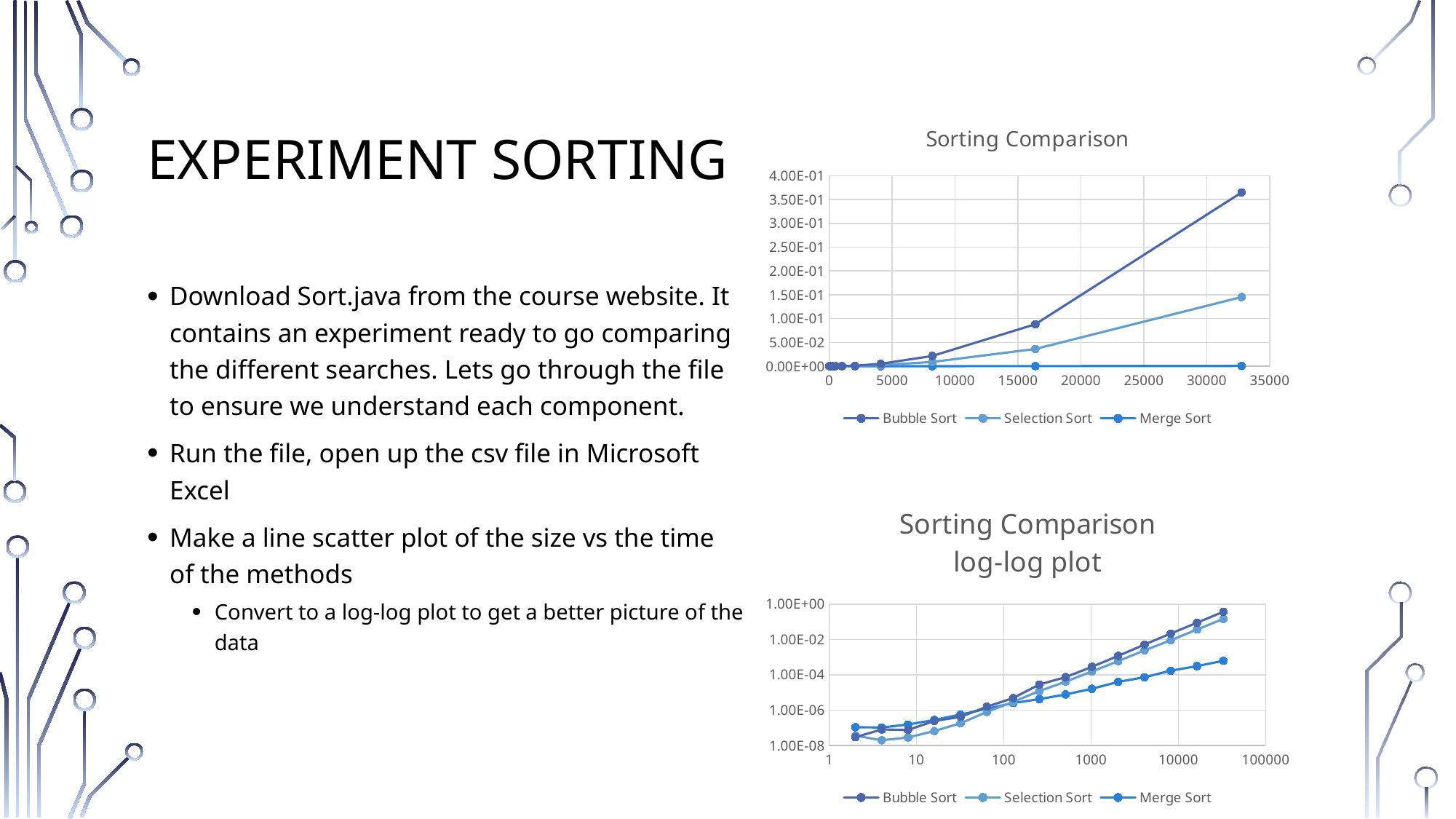
In the "Sorting Comparison" chart, which is larger at the largest input size: Bubble Sort or Selection Sort? Bubble Sort How many series does the legend of the "Sorting Comparison" chart list? 3 In the "Sorting Comparison log-log plot" chart, which series has the lowest value at the largest input size? Merge Sort In the "Sorting Comparison" chart, is the Bubble Sort value at the largest input size greater or less than 3.00E-01? greater What kind of chart is the top chart titled "Sorting Comparison"? line chart In the "Sorting Comparison" chart, does the Bubble Sort series rise or fall as the input size increases? rise In the "Sorting Comparison" chart, which series has the highest value at the largest input size? Bubble Sort In the "Sorting Comparison log-log plot" chart, is the Merge Sort value at the largest input size greater or less than 1.00E-02? less Which series are listed in the legend of the "Sorting Comparison log-log plot" chart? Bubble Sort, Selection Sort, Merge Sort What is the title of the bottom chart? Sorting Comparison log-log plot In the "Sorting Comparison" chart, which series has the lowest value at the largest input size? Merge Sort In the "Sorting Comparison" chart, is the Selection Sort value at the largest input size greater or less than 2.00E-01? less